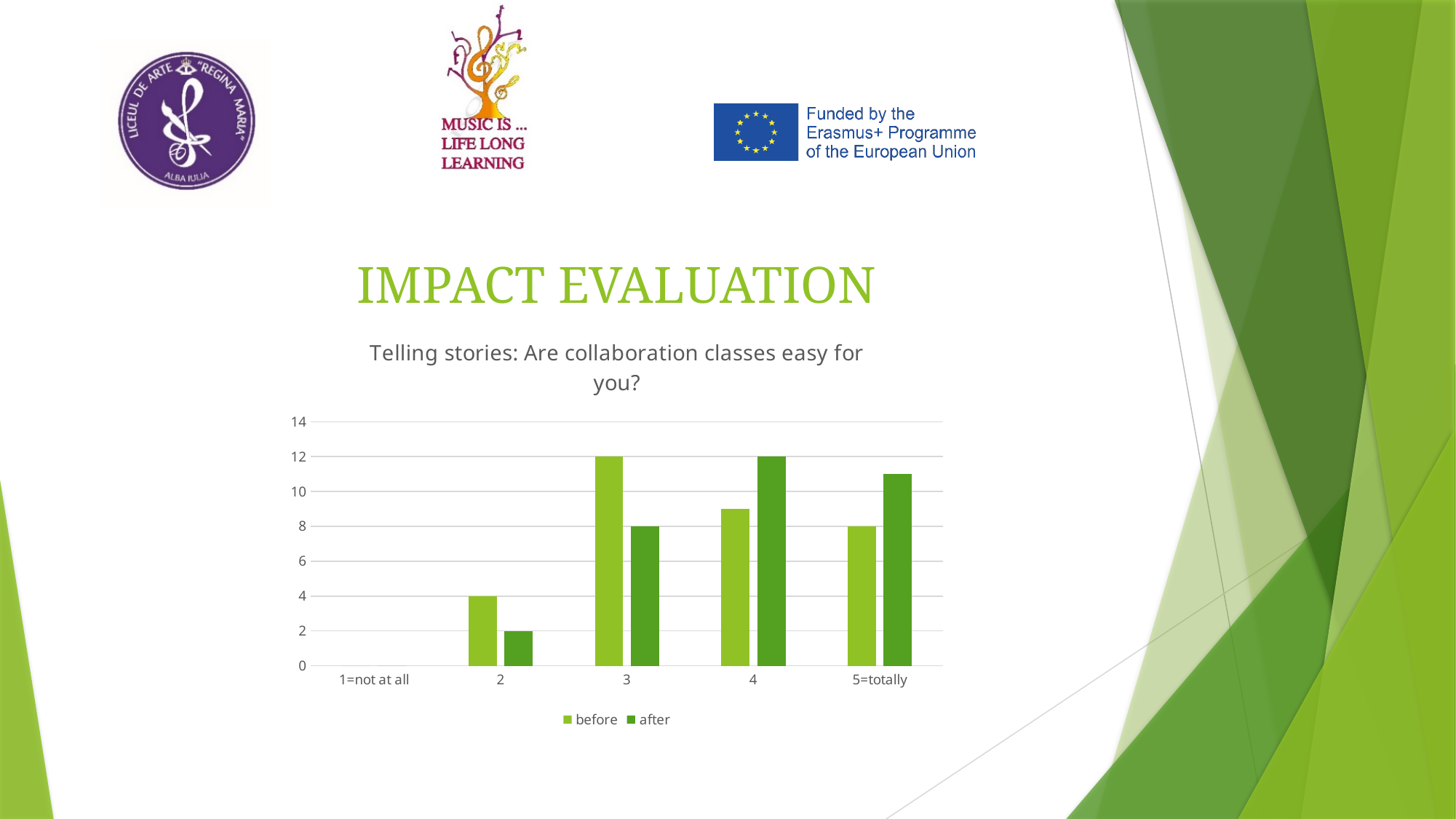
For category 3, which is larger, the 'before' value or the 'after' value? before What is the difference between the 'before' and 'after' values for category 3? 4 Which category has the highest 'after' value? 4 Is the 'before' value for category 4 greater or less than 10? less Which category has the highest 'before' value? 3 What is the 'before' value for category 3? 12 How many series does the legend list? 2 What is the 'before' value for category 2? 4 How many categories are shown on the x axis? 5 What kind of chart is shown on the slide? bar chart What is the 'after' value for category 2? 2 What is the 'after' value for category 4? 12